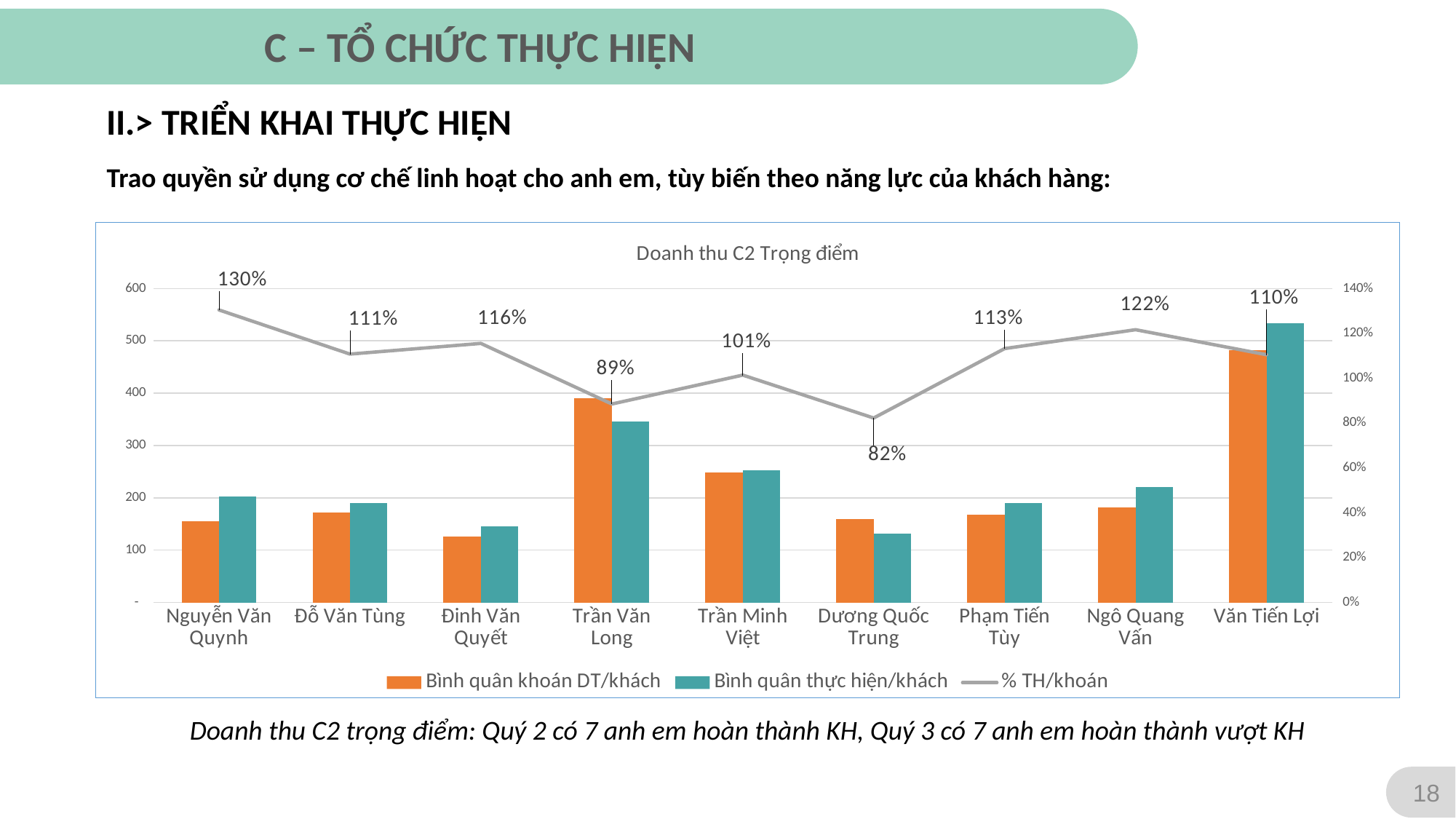
Is the Bình quân khoán DT/khách value for Trần Văn Long greater or less than 300? greater Is the Bình quân thực hiện/khách value for Đinh Văn Quyết greater or less than 200? less Which person has the highest % TH/khoán? Nguyễn Văn Quynh How many people are shown on the x axis of the chart? 9 What is the % TH/khoán value for Ngô Quang Vấn? 122% How many series does the chart legend list? 3 Which person has the lowest % TH/khoán? Dương Quốc Trung Which person has the highest Bình quân thực hiện/khách bar? Văn Tiến Lợi What is the difference in % TH/khoán between Nguyễn Văn Quynh and Dương Quốc Trung? 48 percentage points What is the % TH/khoán value for Trần Văn Long? 89% Who has the larger % TH/khoán, Phạm Tiến Tùy or Ngô Quang Vấn? Ngô Quang Vấn What is the % TH/khoán value for Nguyễn Văn Quynh? 130%